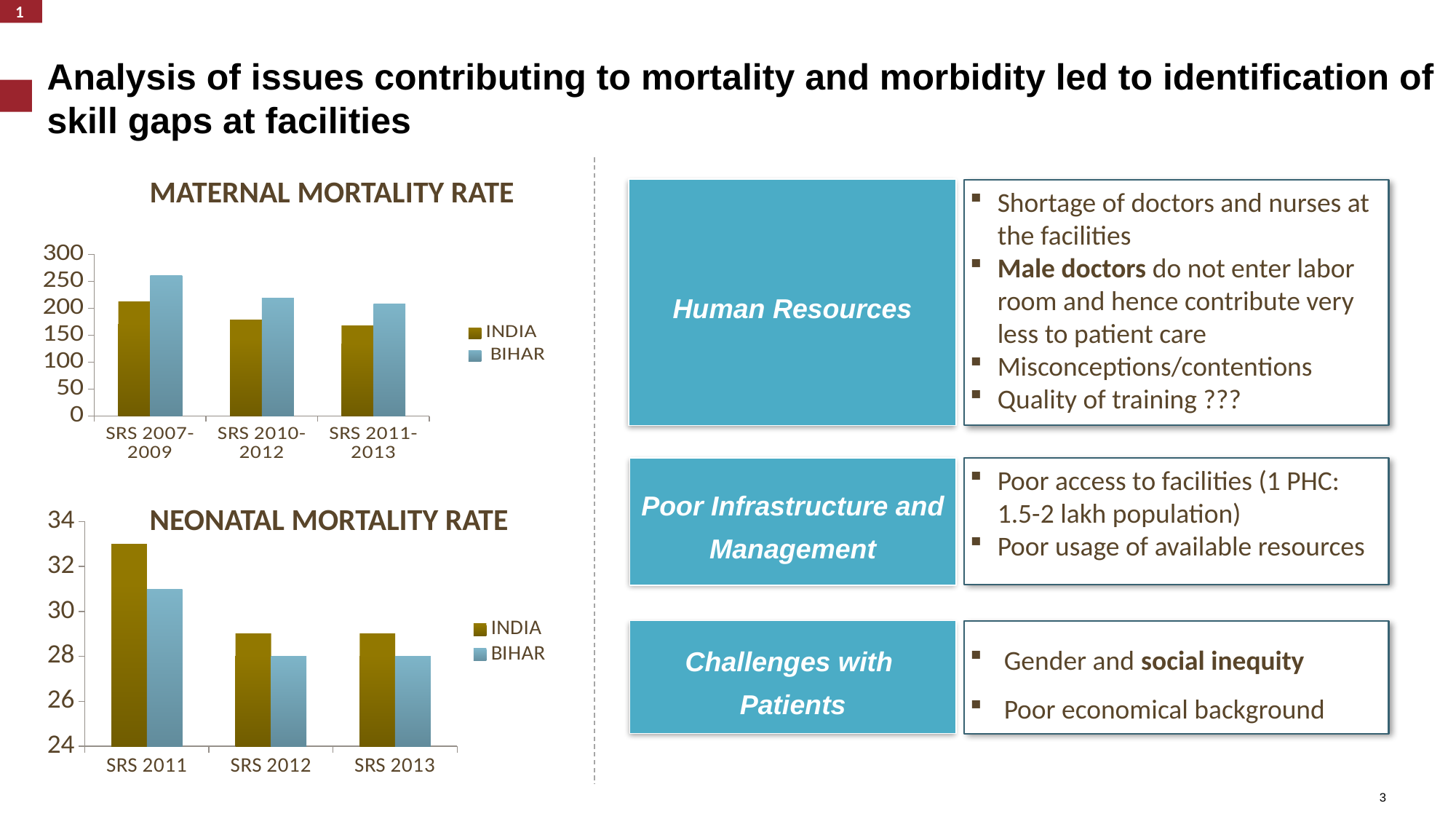
In the Maternal Mortality Rate chart, is the value for BIHAR in SRS 2007-2009 greater or less than 250? greater In the Maternal Mortality Rate chart, which is larger in SRS 2010-2012, INDIA or BIHAR? BIHAR In the Neonatal Mortality Rate chart, which category has the highest INDIA value? SRS 2011 In the Neonatal Mortality Rate chart, which is larger in SRS 2013, INDIA or BIHAR? INDIA What kind of chart is the Maternal Mortality Rate chart? bar chart In the Neonatal Mortality Rate chart, is the value for INDIA in SRS 2011 greater or less than 32? greater In the Maternal Mortality Rate chart, is the value for INDIA in SRS 2011-2013 greater or less than 200? less In the Maternal Mortality Rate chart, which category has the highest BIHAR value? SRS 2007-2009 In the Neonatal Mortality Rate chart, what is the value for BIHAR in SRS 2012? 28 In the Maternal Mortality Rate chart, does the INDIA series rise or fall across the SRS periods? fall How many categories are shown on the x axis of the Maternal Mortality Rate chart? 3 How many series does the legend of the Maternal Mortality Rate chart list? 2